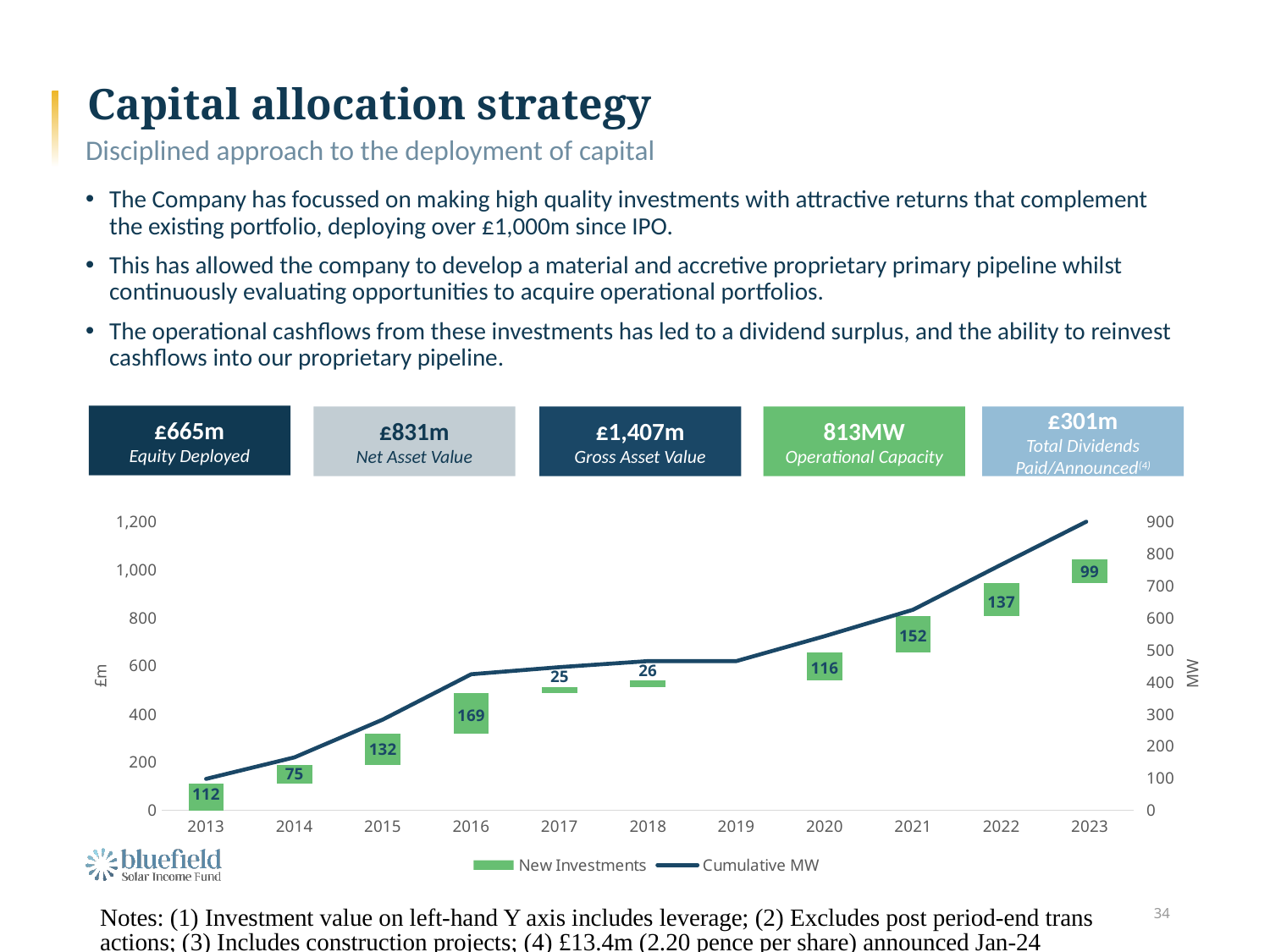
Is the Cumulative MW value for 2023 greater or less than 800? greater What is the difference between the New Investments values for 2016 and 2017? 144 Does the Cumulative MW line rise or fall from 2013 to 2023? Rises How many series does the chart legend list? 2 Is the Cumulative MW value for 2016 greater or less than 300? greater What is the New Investments value for 2016? 169 Which year has the highest New Investments value? 2016 How many years are shown on the x axis of the chart? 11 What is the New Investments value for 2013? 112 What kind of chart is shown on the slide? Combined bar and line chart What is the New Investments value for 2021? 152 Which is larger, the New Investments value for 2021 or for 2022? 2021